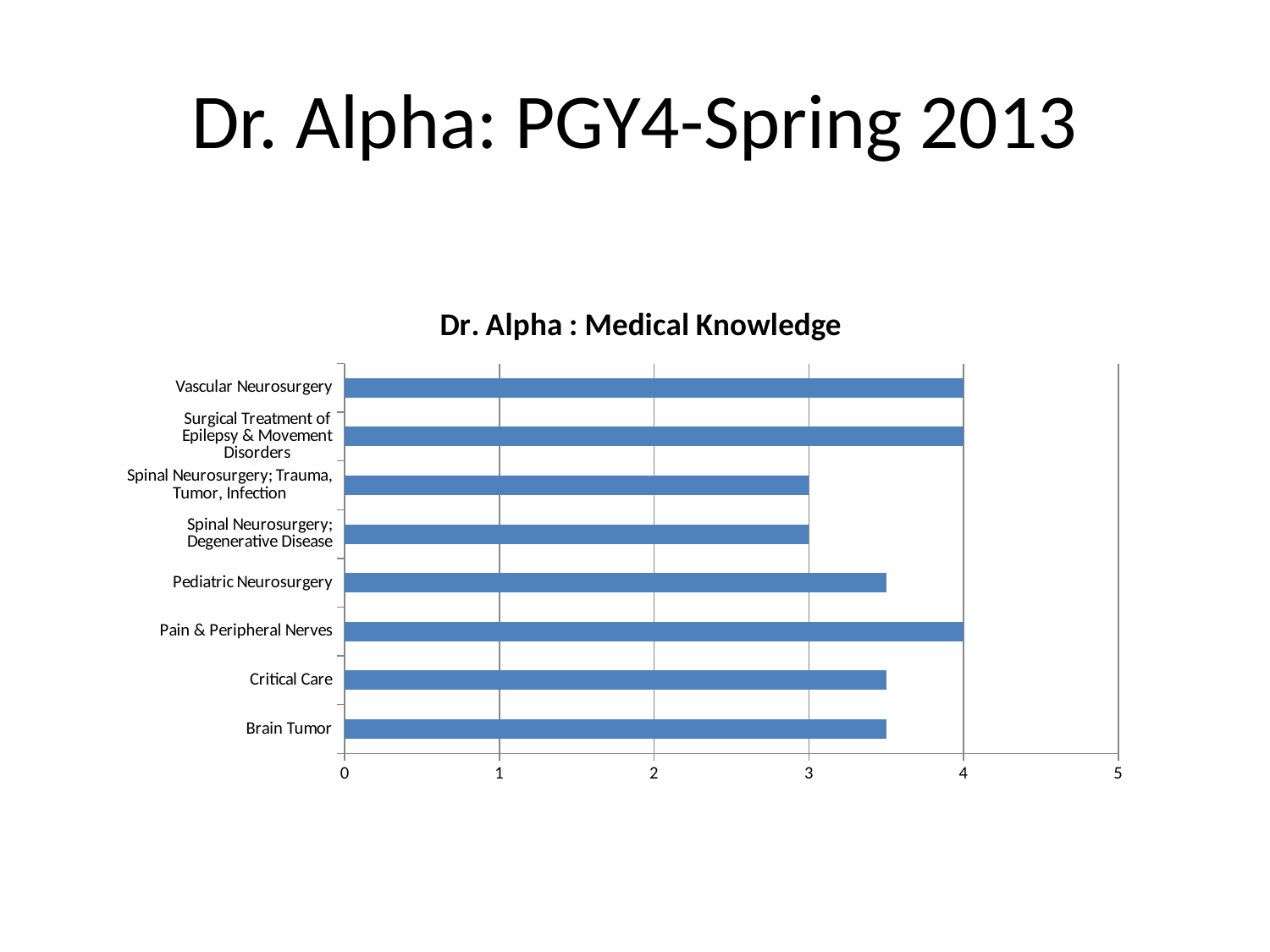
What is the value for Spinal Neurosurgery; Degenerative Disease? 3 What is the value for Vascular Neurosurgery? 4 Which is larger, the value for Vascular Neurosurgery or the value for Spinal Neurosurgery; Degenerative Disease? Vascular Neurosurgery What is the value for Pain & Peripheral Nerves? 4 Which is larger, the value for Pediatric Neurosurgery or the value for Pain & Peripheral Nerves? Pain & Peripheral Nerves What is the difference between the value for Surgical Treatment of Epilepsy & Movement Disorders and the value for Spinal Neurosurgery; Trauma, Tumor, Infection? 1 What kind of chart is shown on the slide? bar chart What is the value for Spinal Neurosurgery; Trauma, Tumor, Infection? 3 Is the value for Brain Tumor greater or less than 3? greater Is the value for Critical Care greater or less than 4? less Is the value for Pediatric Neurosurgery greater or less than 3? greater How many categories are shown in the chart? 8